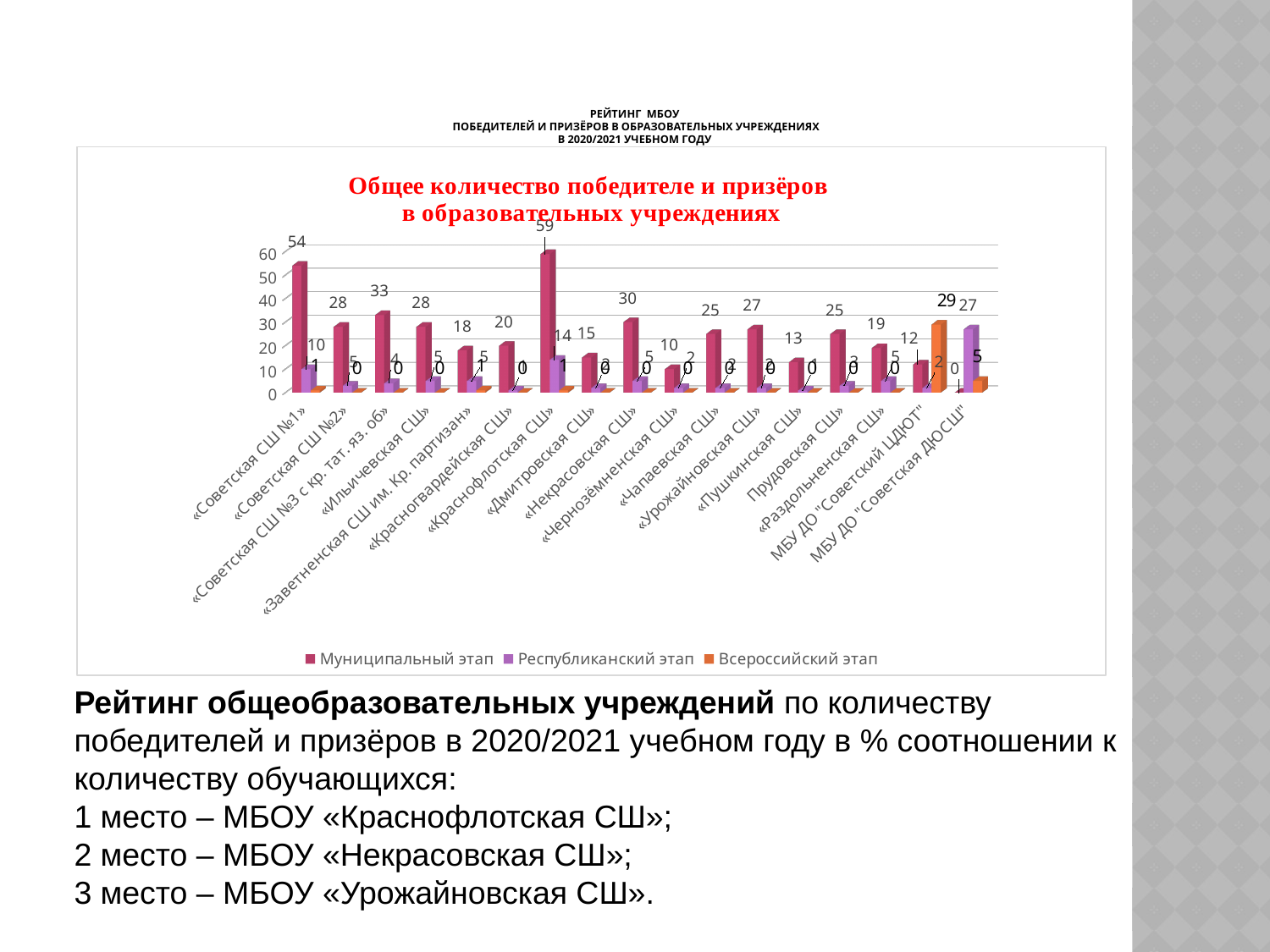
What is the value of Муниципальный этап for «Советская СШ №1»? 54 What kind of chart is shown on the slide? bar chart Which series is shown in orange in the legend? Всероссийский этап What is the value of Всероссийский этап for МБУ ДО "Советский ЦДЮТ"? 29 What is the value of Республиканский этап for МБУ ДО "Советская ДЮСШ"? 27 How many series does the legend list? 3 What is the value of Муниципальный этап for «Краснофлотская СШ»? 59 Which institution has the highest value for Всероссийский этап? МБУ ДО "Советский ЦДЮТ" What is the difference between the Муниципальный этап values for «Краснофлотская СШ» and «Советская СШ №1»? 5 Which institution has the highest value for Муниципальный этап? «Краснофлотская СШ» Which has the larger Муниципальный этап value: «Советская СШ №3 с кр. тат. яз. об» or «Некрасовская СШ»? «Советская СШ №3 с кр. тат. яз. об» How many educational institutions (categories) are shown on the x axis? 17